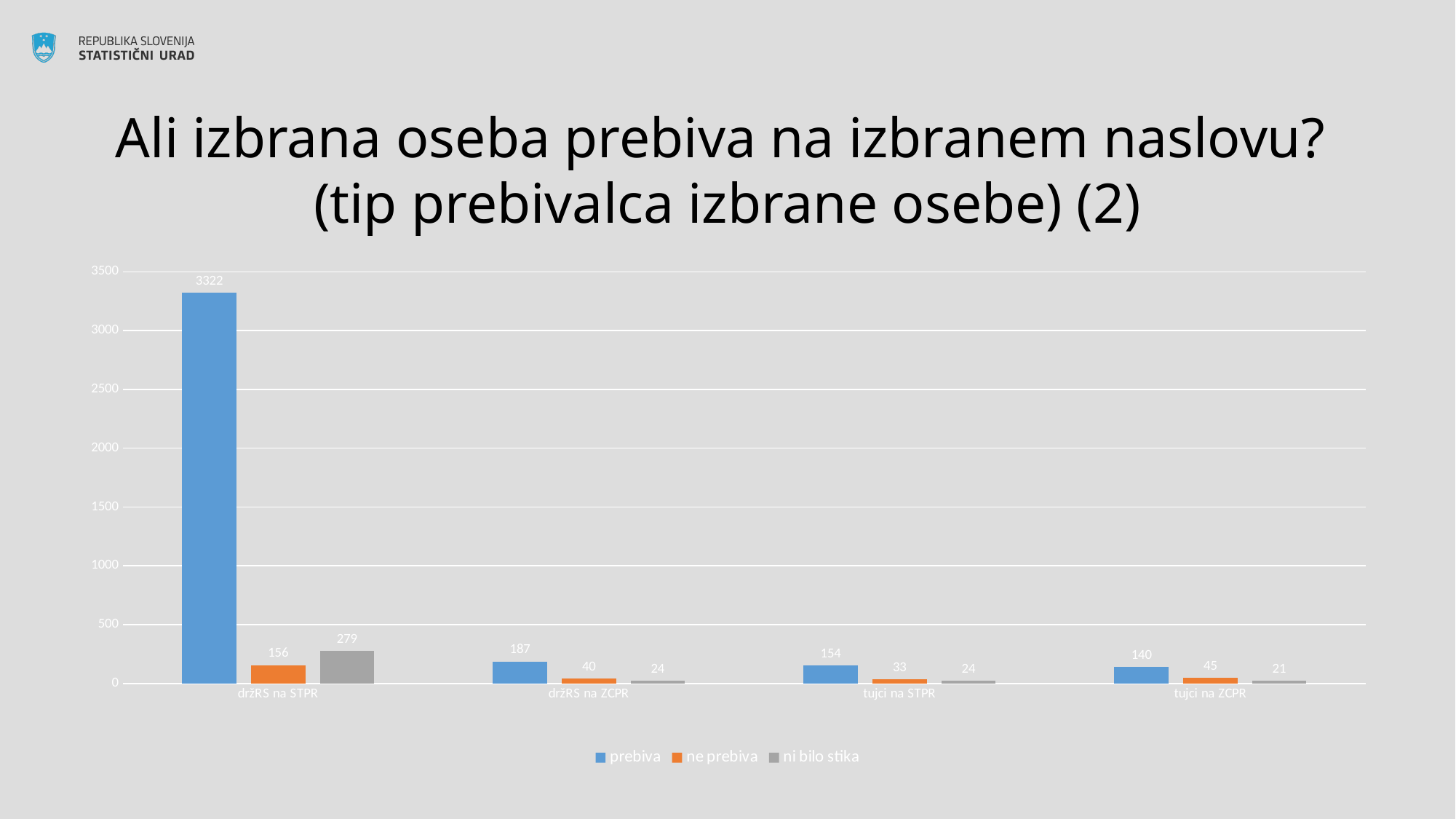
Which category has the highest 'prebiva' value? držRS na STPR How many categories are shown on the x axis? 4 What is the value of 'ni bilo stika' for 'držRS na STPR'? 279 What is the difference between the 'prebiva' values for 'držRS na ZCPR' and 'tujci na ZCPR'? 47 Which category has the lowest 'ni bilo stika' value? tujci na ZCPR Is the 'prebiva' value for 'držRS na STPR' greater or less than 3000? greater What is the value of 'prebiva' for 'držRS na STPR'? 3322 What kind of chart is shown on the slide? bar chart What is the value of 'prebiva' for 'tujci na STPR'? 154 Which is larger: 'ne prebiva' for 'držRS na STPR' or 'ne prebiva' for 'držRS na ZCPR'? držRS na STPR How many series does the legend list? 3 What is the value of 'ne prebiva' for 'tujci na ZCPR'? 45